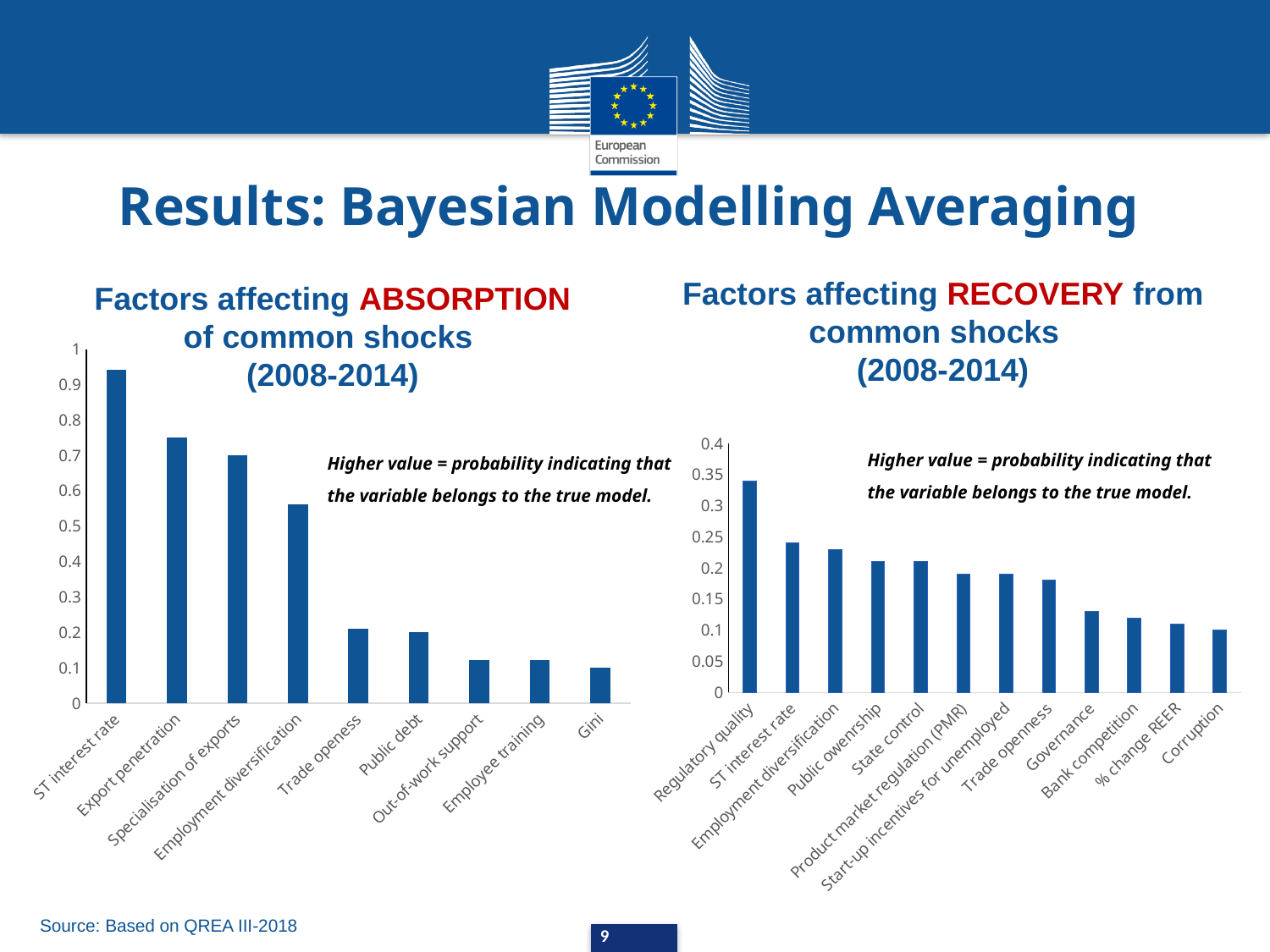
In the 'Factors affecting ABSORPTION of common shocks' chart, how many factors are plotted? 9 In the 'Factors affecting RECOVERY from common shocks' chart, which factor has the highest value? Regulatory quality In the 'Factors affecting RECOVERY from common shocks' chart, is the value for Regulatory quality greater or less than 0.3? greater In the 'Factors affecting RECOVERY from common shocks' chart, is the value for Governance greater or less than 0.15? less In the 'Factors affecting ABSORPTION of common shocks' chart, which factor has the lowest value? Gini In the 'Factors affecting ABSORPTION of common shocks' chart, which is larger: Export penetration or Public debt? Export penetration In the 'Factors affecting ABSORPTION of common shocks' chart, is the value for ST interest rate greater or less than 0.9? greater In the 'Factors affecting ABSORPTION of common shocks' chart, which factor has the highest value? ST interest rate In the 'Factors affecting RECOVERY from common shocks' chart, how many factors are plotted? 12 What type of chart is the 'Factors affecting RECOVERY from common shocks' chart? Bar chart